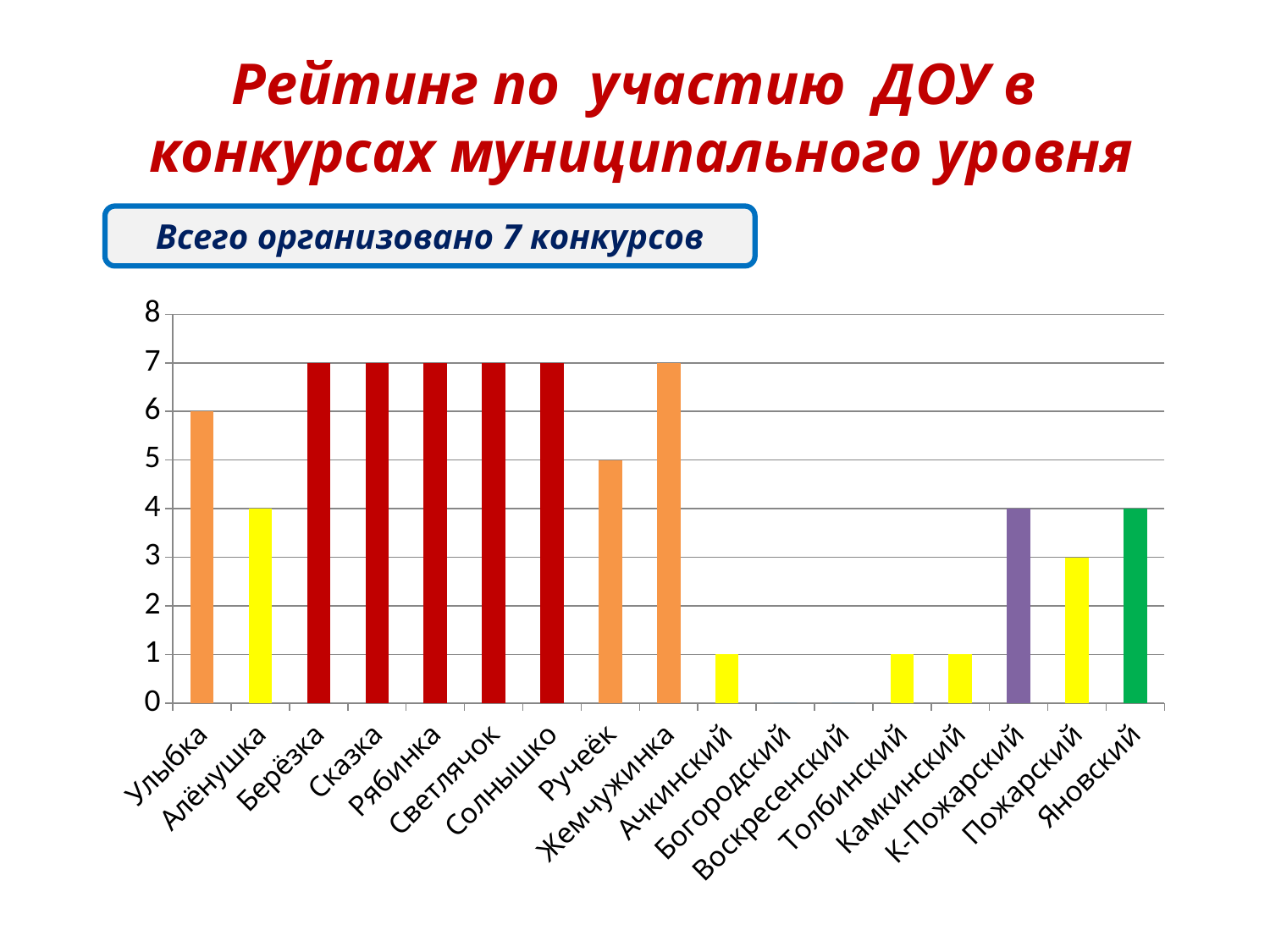
Which has the larger value, Улыбка or Ручеёк? Улыбка What is the difference between the values for Берёзка and Пожарский? 4 What is the value for Пожарский? 3 What kind of chart is shown on the slide? bar chart Is the value for Камкинский greater or less than 3? less How many categories (ДОУ) are shown on the x axis of the chart? 17 Which has the larger value, К-Пожарский or Ачкинский? К-Пожарский What is the value for Алёнушка? 4 Is the value for Жемчужинка greater or less than 5? greater What is the value for Улыбка? 6 What is the value for Ручеёк? 5 What is the title of the chart on the slide? Рейтинг по участию ДОУ в конкурсах муниципального уровня